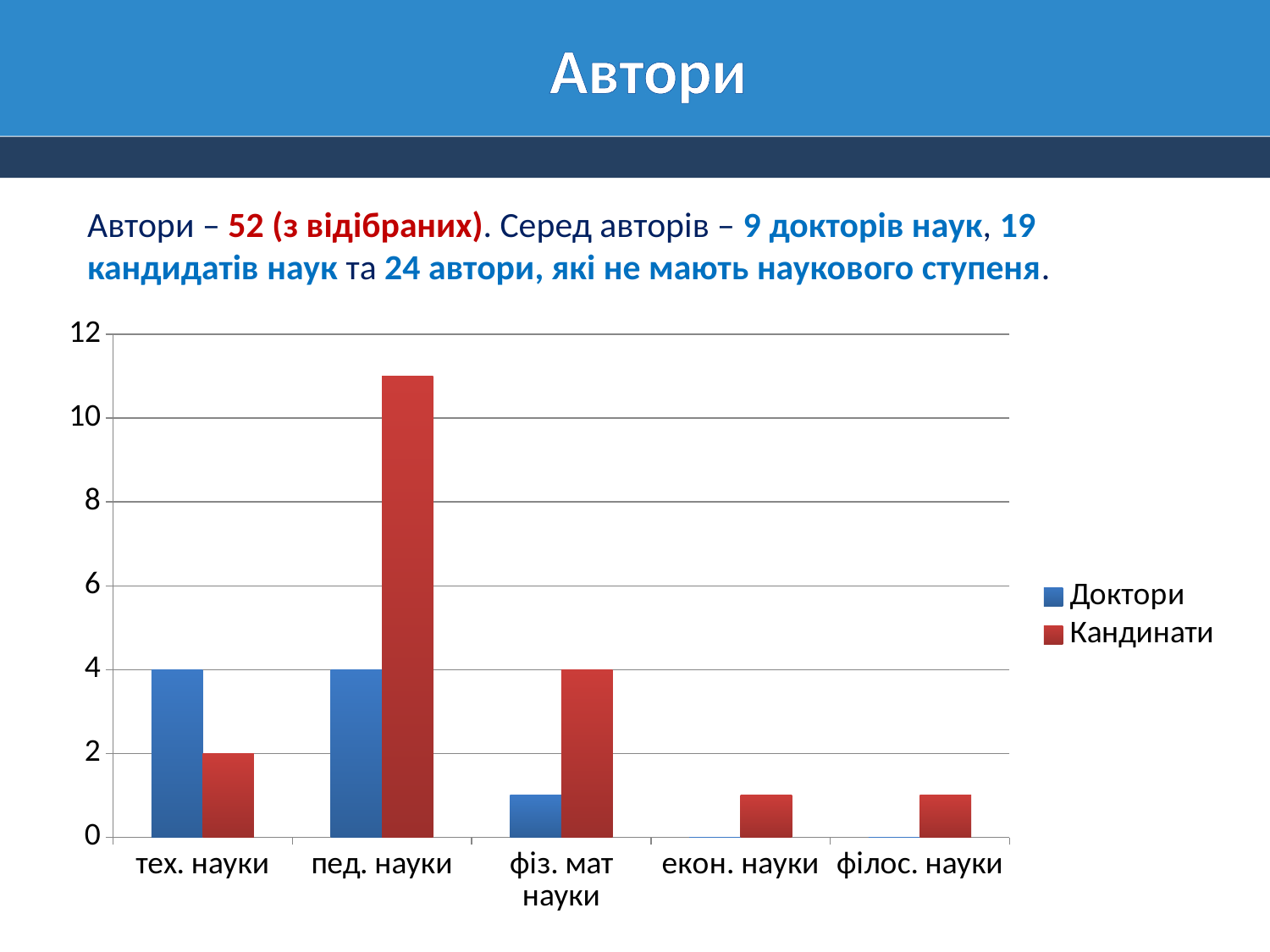
How many series does the legend list? 2 Which category has the highest value for Кандинати? пед. науки What type of chart is shown on the slide? bar chart What is the value for Кандинати in the тех. науки category? 2 Is the value for Кандинати in пед. науки greater or less than 10? greater Is the value for Доктори in фіз. мат науки greater or less than 2? less What is the difference between the Доктори and Кандинати values in the тех. науки category? 2 What is the value for Кандинати in the фіз. мат науки category? 4 In the пед. науки category, which series has the larger value, Доктори or Кандинати? Кандинати What is the value for Доктори in the пед. науки category? 4 What is the value for Доктори in the тех. науки category? 4 How many categories are shown on the x axis? 5